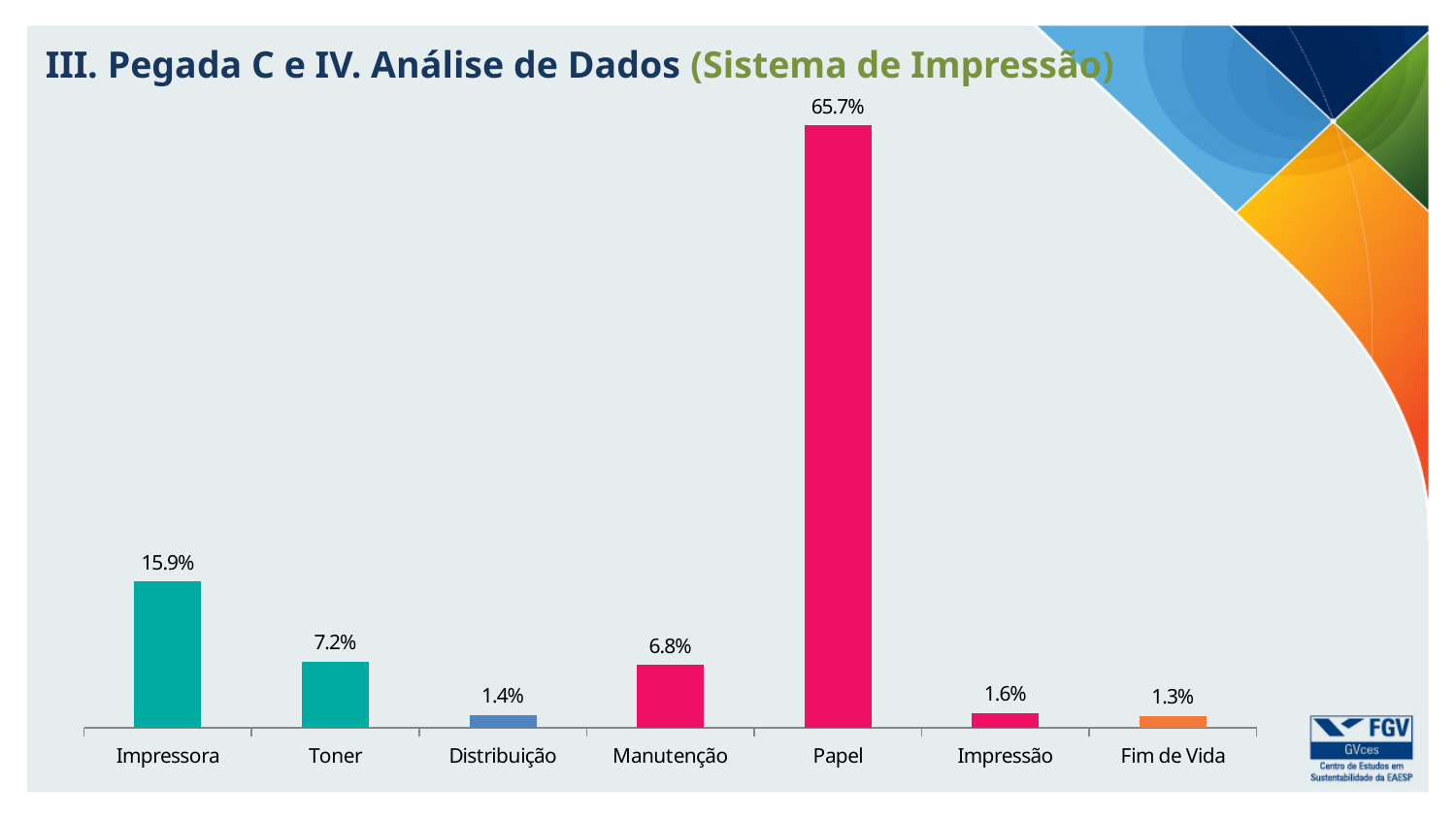
What is the value for Distribuição? 1.4% Which is larger, the value for Toner or the value for Manutenção? Toner How many categories are shown on the x axis? 7 Which category has the lowest value? Fim de Vida What kind of chart is shown on the slide? Bar chart What is the value for Fim de Vida? 1.3% What is the value for Papel? 65.7% Which category has the highest value? Papel What is the difference between the values for Papel and Manutenção? 58.9% What is the difference between the values for Impressora and Toner? 8.7% What is the value for Impressora? 15.9% What colour is the bar for Fim de Vida? Orange